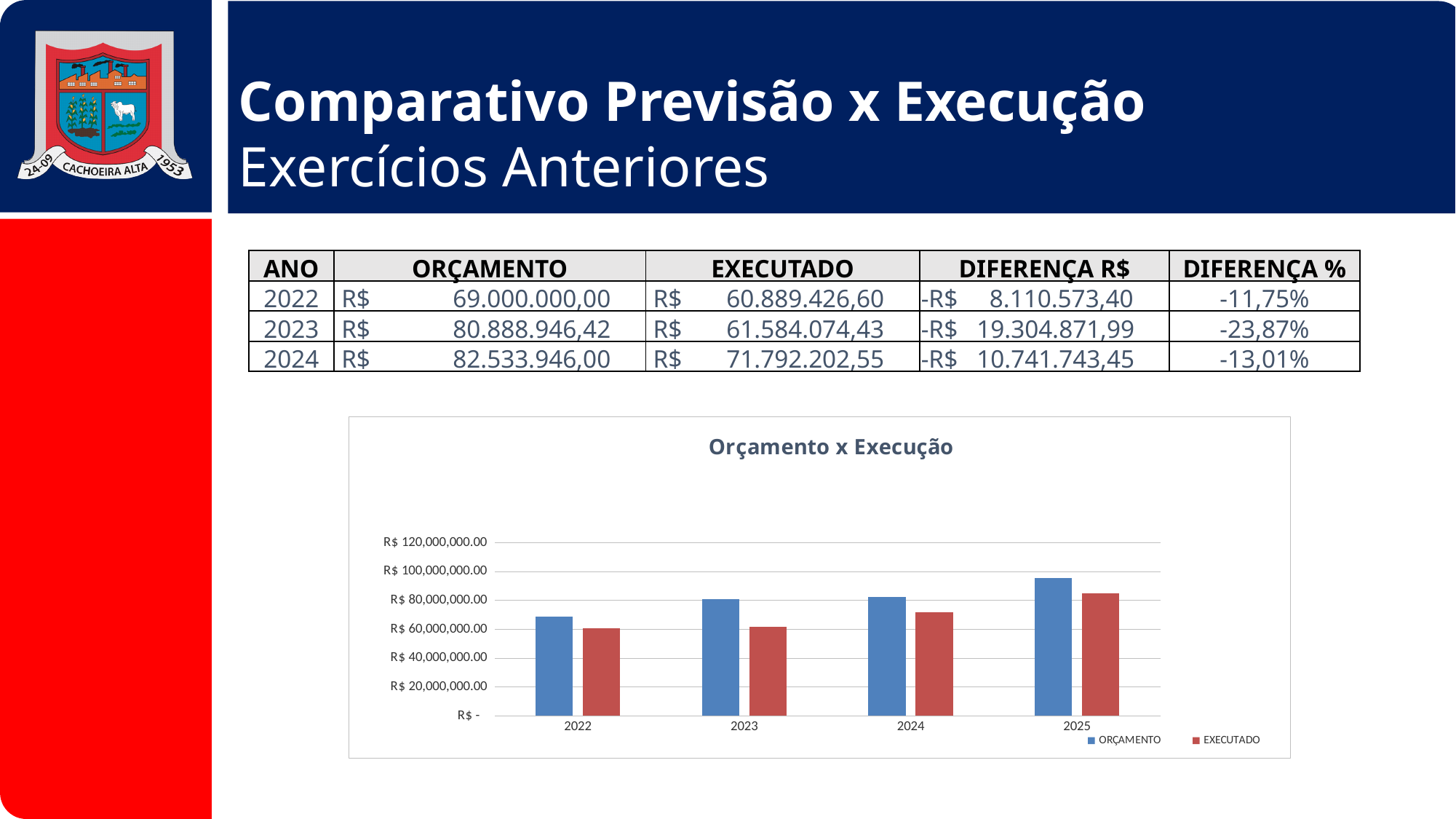
In the 'Orçamento x Execução' chart, is the ORÇAMENTO value for 2025 greater or less than R$ 80,000,000.00? greater What kind of chart is 'Orçamento x Execução'? bar chart In the 'Orçamento x Execução' chart, which year has the highest ORÇAMENTO bar? 2025 In the 'Orçamento x Execução' chart, which year has the lowest ORÇAMENTO bar? 2022 In the 'Orçamento x Execução' chart, is the ORÇAMENTO value for 2022 greater or less than R$ 60,000,000.00? greater Which colour represents EXECUTADO in the 'Orçamento x Execução' chart? red How many series does the legend of the 'Orçamento x Execução' chart list? 2 In the 'Orçamento x Execução' chart, which year has the highest EXECUTADO bar? 2025 In the 'Orçamento x Execução' chart, which is larger for 2023: ORÇAMENTO or EXECUTADO? ORÇAMENTO In the 'Orçamento x Execução' chart, is the EXECUTADO value for 2025 greater or less than R$ 100,000,000.00? less How many years are shown on the x axis of the 'Orçamento x Execução' chart? 4 In the 'Orçamento x Execução' chart, do the ORÇAMENTO values rise or fall from 2022 to 2025? rise